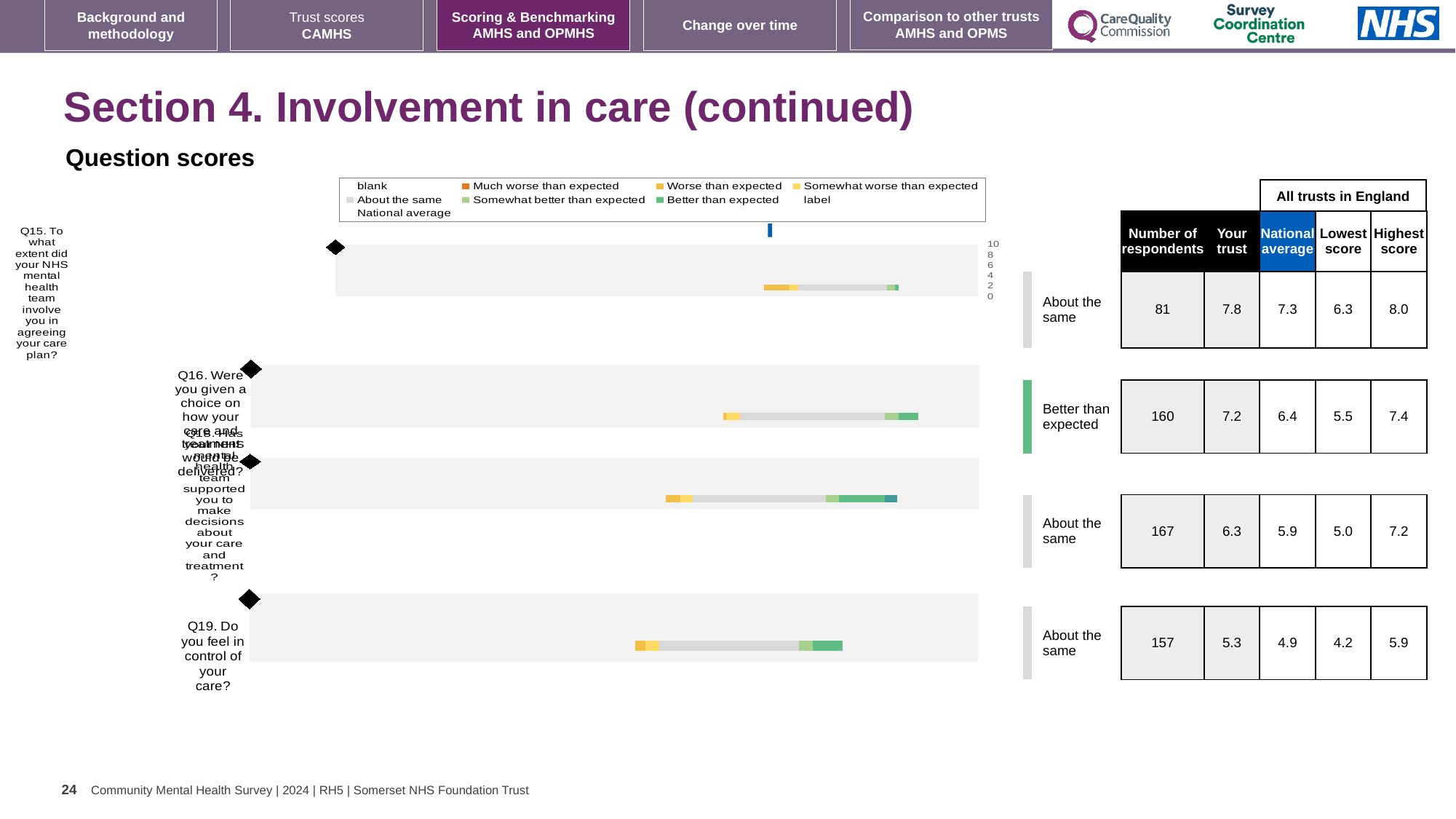
For Q15, what is the difference between the 'Your trust' score and the national average in the table? 0.5 What kind of chart is used to show the question scores on this slide? bar chart How many entries does the legend above the question scores chart list? 9 In the table next to the chart, what is the national average for Q19? 4.9 Which question has the highest 'Your trust' score in the table next to the chart? Q15 Which question has the lowest 'Your trust' score in the table next to the chart? Q19 In the legend of the question scores chart, what colour represents 'Better than expected'? green In the legend of the question scores chart, what colour represents 'Much worse than expected'? orange In the table next to the chart, how many respondents are listed for Q16? 160 How many questions (Q15, Q16, Q18, Q19) are plotted as bars in the question scores chart? 4 In the table next to the chart, what is the highest score for Q18? 7.2 In the table next to the chart, what is the 'Your trust' score for Q15? 7.8